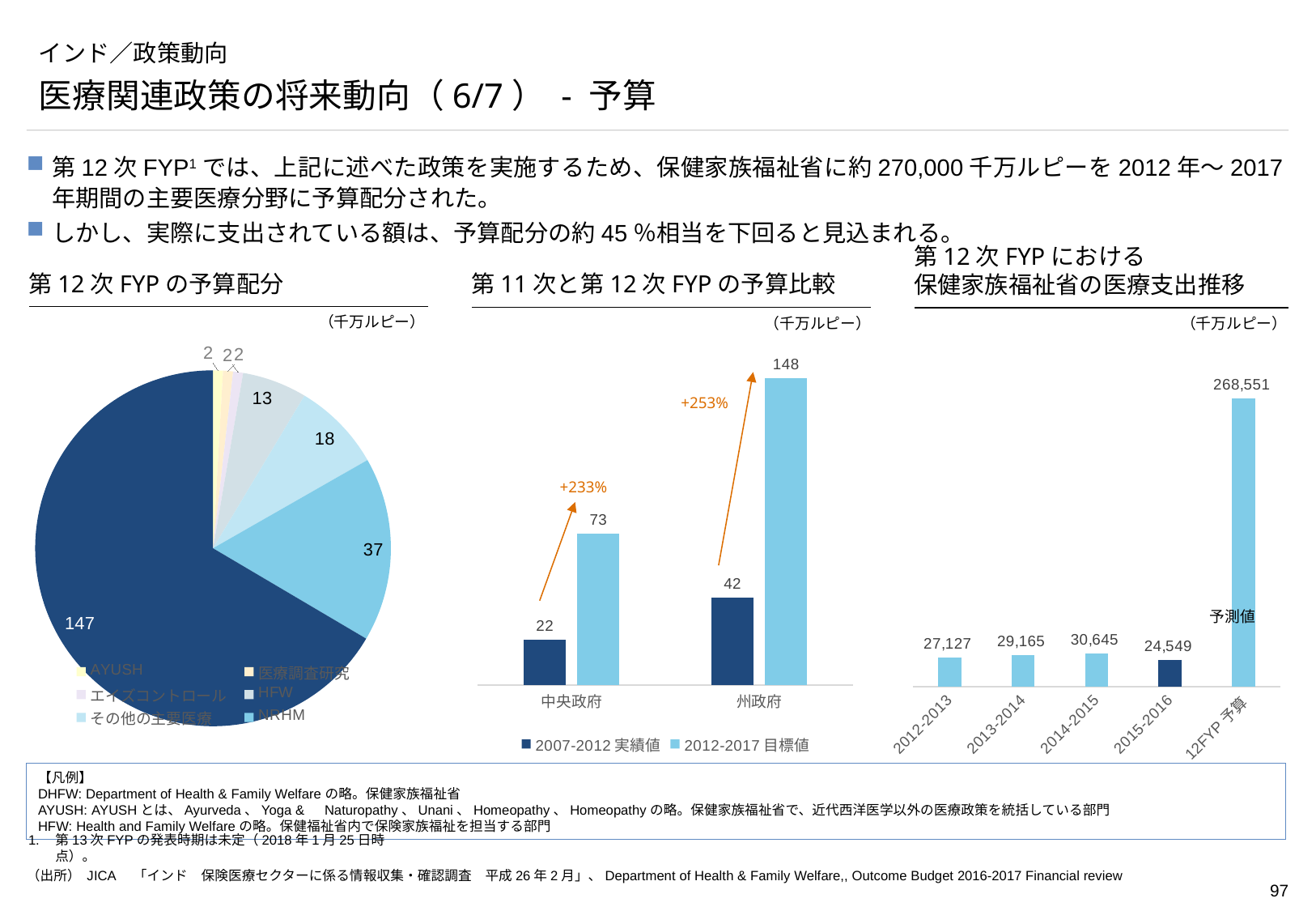
In the chart titled 第11次と第12次FYPの予算比較, what is the 2012-2017 目標値 for 州政府? 148 In the chart titled 第12次FYPにおける保健家族福祉省の医療支出推移, how many categories are shown on the x axis? 5 In the chart titled 第11次と第12次FYPの予算比較, how many series does the legend list? 2 In the pie chart titled 第12次FYPの予算配分, what is the value of the largest slice? 147 In the chart titled 第11次と第12次FYPの予算比較, what is the 2007-2012 実績値 for 中央政府? 22 In the chart titled 第12次FYPにおける保健家族福祉省の医療支出推移, what is the value for 12FYP予算? 268,551 In the chart titled 第11次と第12次FYPの予算比較, what percentage increase is shown for 州政府? +253% What kind of chart is the one titled 第12次FYPの予算配分? pie chart In the chart titled 第12次FYPにおける保健家族福祉省の医療支出推移, what is the value for 2014-2015? 30,645 In the chart titled 第11次と第12次FYPの予算比較, what is the difference between the 2012-2017 目標値 and the 2007-2012 実績値 for 中央政府? 51 In the chart titled 第12次FYPにおける保健家族福祉省の医療支出推移, which category has the lowest value? 2015-2016 In the chart titled 第12次FYPにおける保健家族福祉省の医療支出推移, what is the difference between the values for 2013-2014 and 2012-2013? 2,038